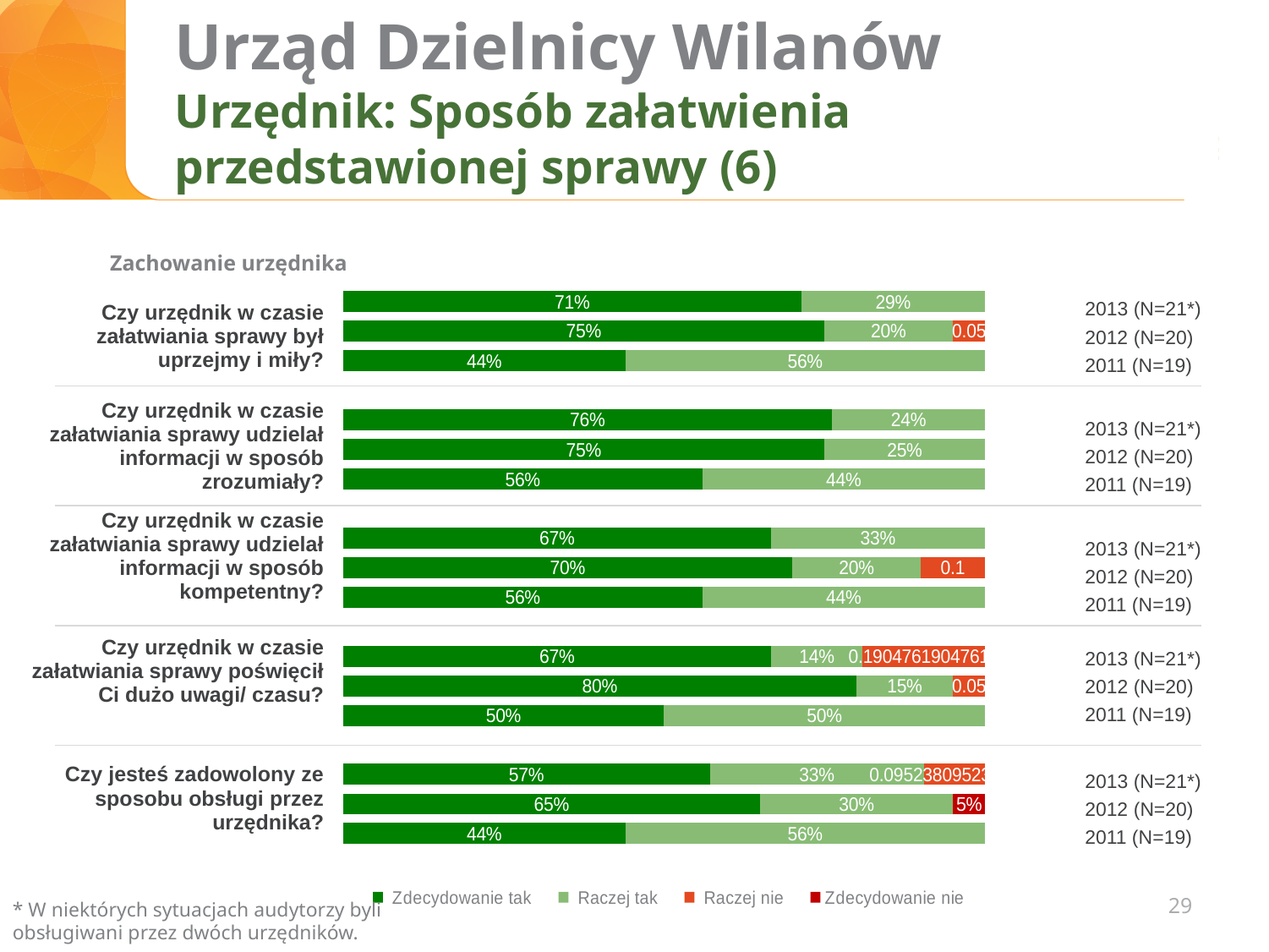
For the question 'Czy urzędnik w czasie załatwiania sprawy był uprzejmy i miły?', which year has the larger 'Zdecydowanie tak' value, 2013 or 2011? 2013 What is the 'Zdecydowanie nie' value for 2012 for the question 'Czy jesteś zadowolony ze sposobu obsługi przez urzędnika?' 5% Among the 2013 bars, which question has the highest 'Zdecydowanie tak' share? Czy urzędnik w czasie załatwiania sprawy udzielał informacji w sposób zrozumiały? What is the 'Raczej tak' value for 2011 for the question 'Czy jesteś zadowolony ze sposobu obsługi przez urzędnika?' 56% How many questions (categories) are shown in the chart? 5 How many series does the legend list? 4 What is the 'Zdecydowanie tak' value for 2012 for the question 'Czy urzędnik w czasie załatwiania sprawy poświęcił Ci dużo uwagi/ czasu?' 80% For the question 'Czy urzędnik w czasie załatwiania sprawy udzielał informacji w sposób kompetentny?', what is the difference between the 'Zdecydowanie tak' values for 2012 and 2011? 14% Which legend entry is shown in the darkest green colour? Zdecydowanie tak Among the 2013 bars, which question has the lowest 'Zdecydowanie tak' share? Czy jesteś zadowolony ze sposobu obsługi przez urzędnika? What is the 'Zdecydowanie tak' value for 2013 for the question 'Czy urzędnik w czasie załatwiania sprawy był uprzejmy i miły?' 71% What kind of chart is shown on the slide? stacked bar chart